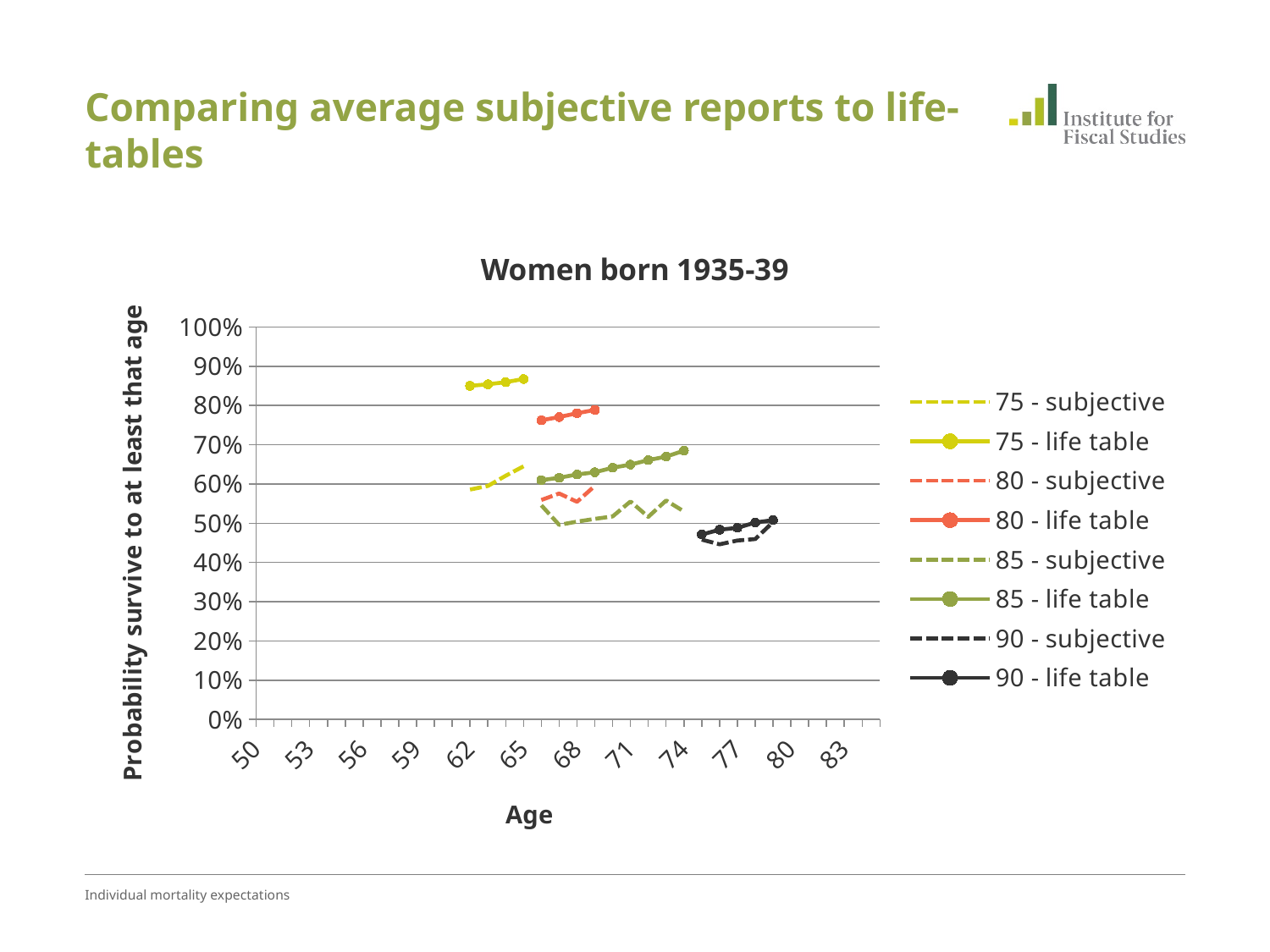
Which series has the highest values on the chart? 75 - life table Do the values for the 85 - life table series rise or fall as age increases? rise Are the values for the 75 - life table series greater or less than 80%? greater Which series is higher, 80 - life table or 80 - subjective? 80 - life table Are the values for the 75 - subjective series greater or less than 70%? less Are the values for the 85 - life table series greater or less than 70%? less How many series does the legend list? 8 What is the title of the chart? Women born 1935-39 What kind of chart is shown on the slide? line chart What is the label of the vertical axis? Probability survive to at least that age